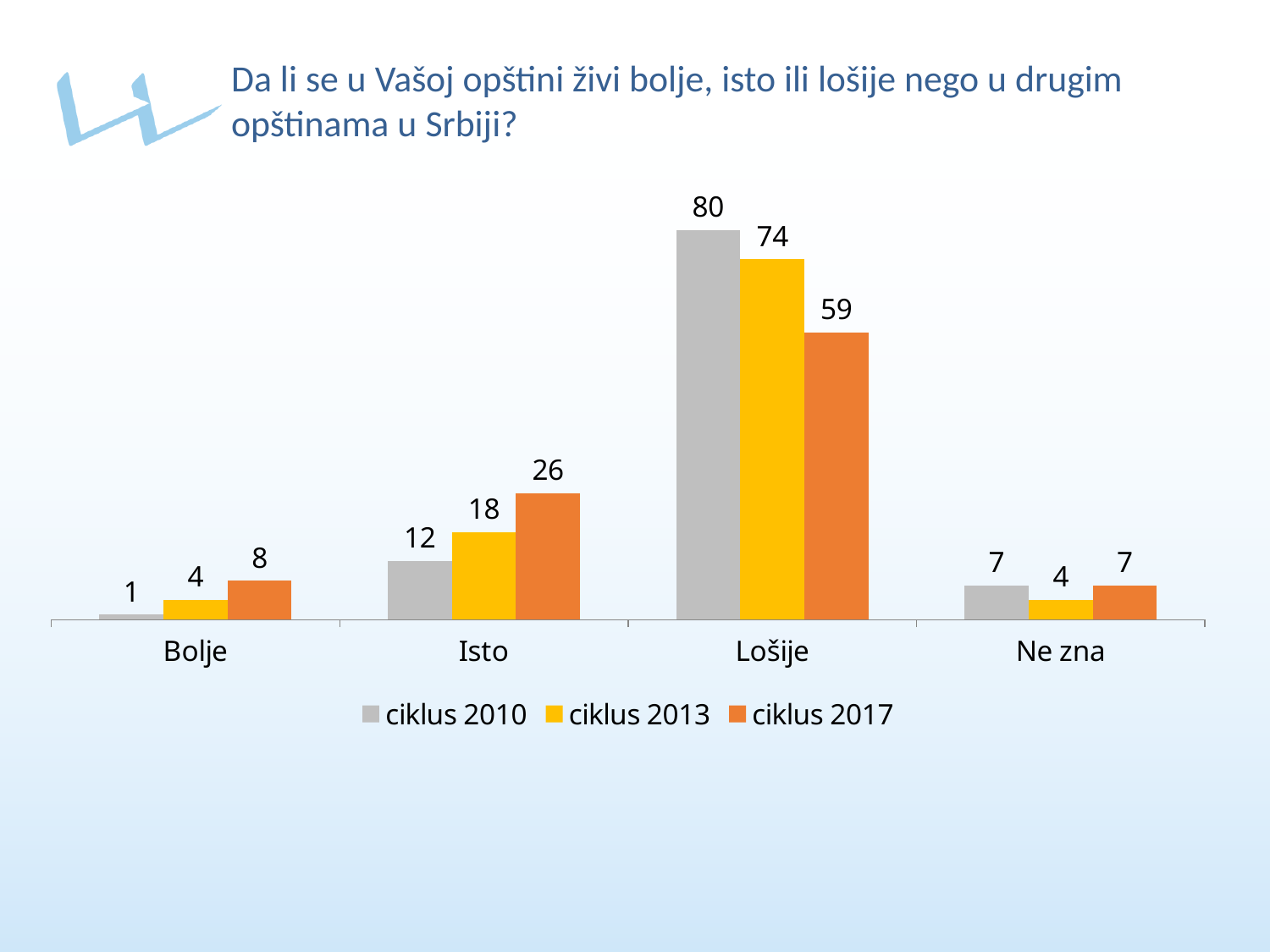
Which category has the lowest value in the ciklus 2010 series? Bolje What is the value for Bolje in the ciklus 2013 series? 4 How many categories are shown on the x axis? 4 What is the value for Lošije in the ciklus 2010 series? 80 Does the value for Lošije rise or fall from ciklus 2010 to ciklus 2017? fall What kind of chart is shown on the slide? bar chart How many series does the legend list? 3 Which colour represents the ciklus 2013 series? yellow What is the value for Isto in the ciklus 2017 series? 26 Which category has the highest value in the ciklus 2017 series? Lošije Which is larger for Isto: the ciklus 2013 value or the ciklus 2017 value? ciklus 2017 What is the difference between the ciklus 2010 and ciklus 2017 values for Lošije? 21